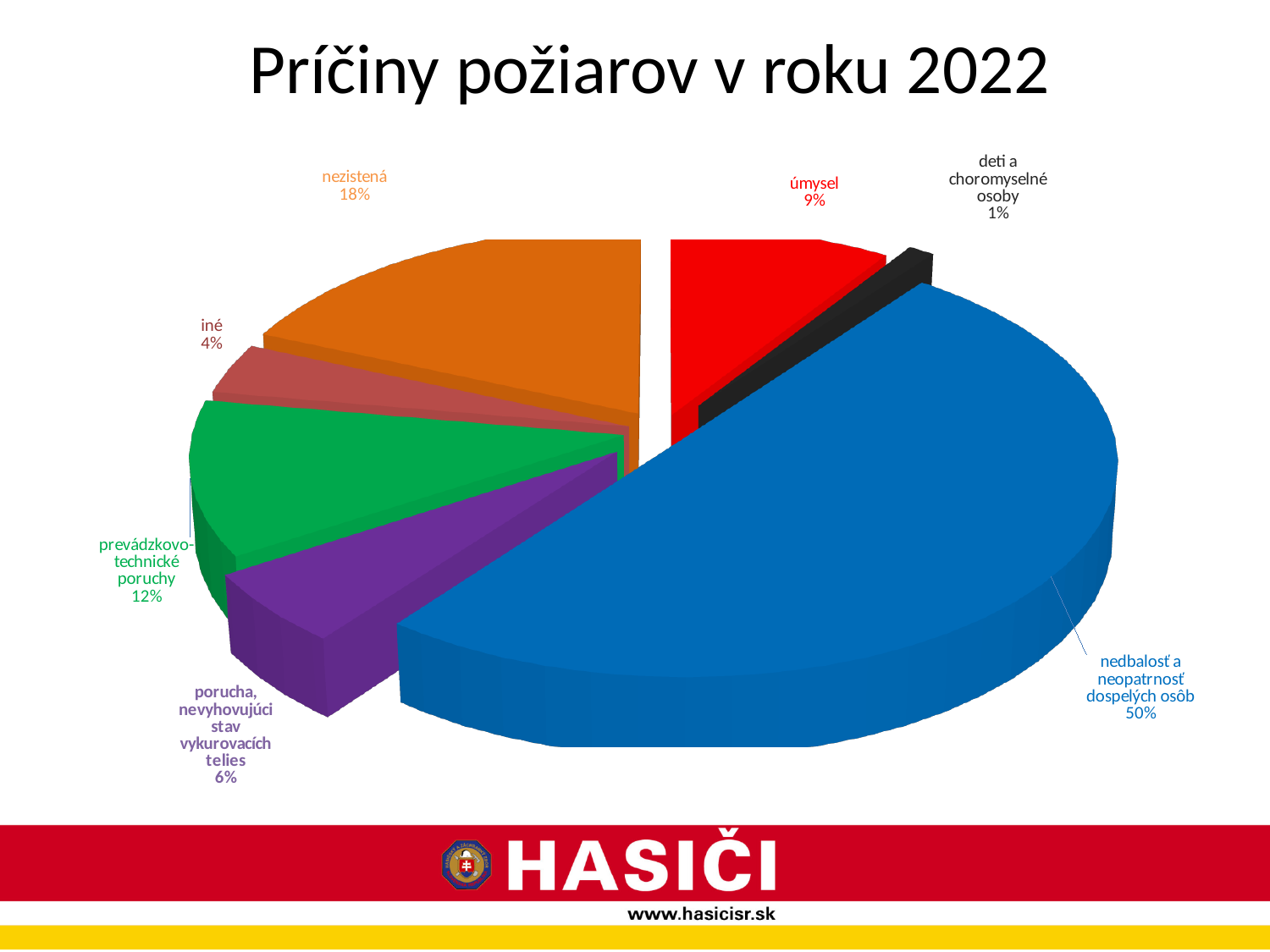
What share of the pie does 'nedbalosť a neopatrnosť dospelých osôb' represent? 50% What percentage is shown for 'prevádzkovo-technické poruchy'? 12% How many categories are shown in the pie chart? 7 Which category has the largest share of the pie? nedbalosť a neopatrnosť dospelých osôb What is the difference between the shares of 'nezistená' and 'úmysel'? 9% Which is larger, the share for 'iné' or the share for 'prevádzkovo-technické poruchy'? prevádzkovo-technické poruchy Which category has the smallest share of the pie? deti a choromyselné osoby What is the value for 'úmysel'? 9% What is the value shown for 'nezistená'? 18% What type of chart is shown on the slide? pie chart What percentage is shown for 'porucha, nevyhovujúci stav vykurovacích telies'? 6% What is the title of the chart? Príčiny požiarov v roku 2022